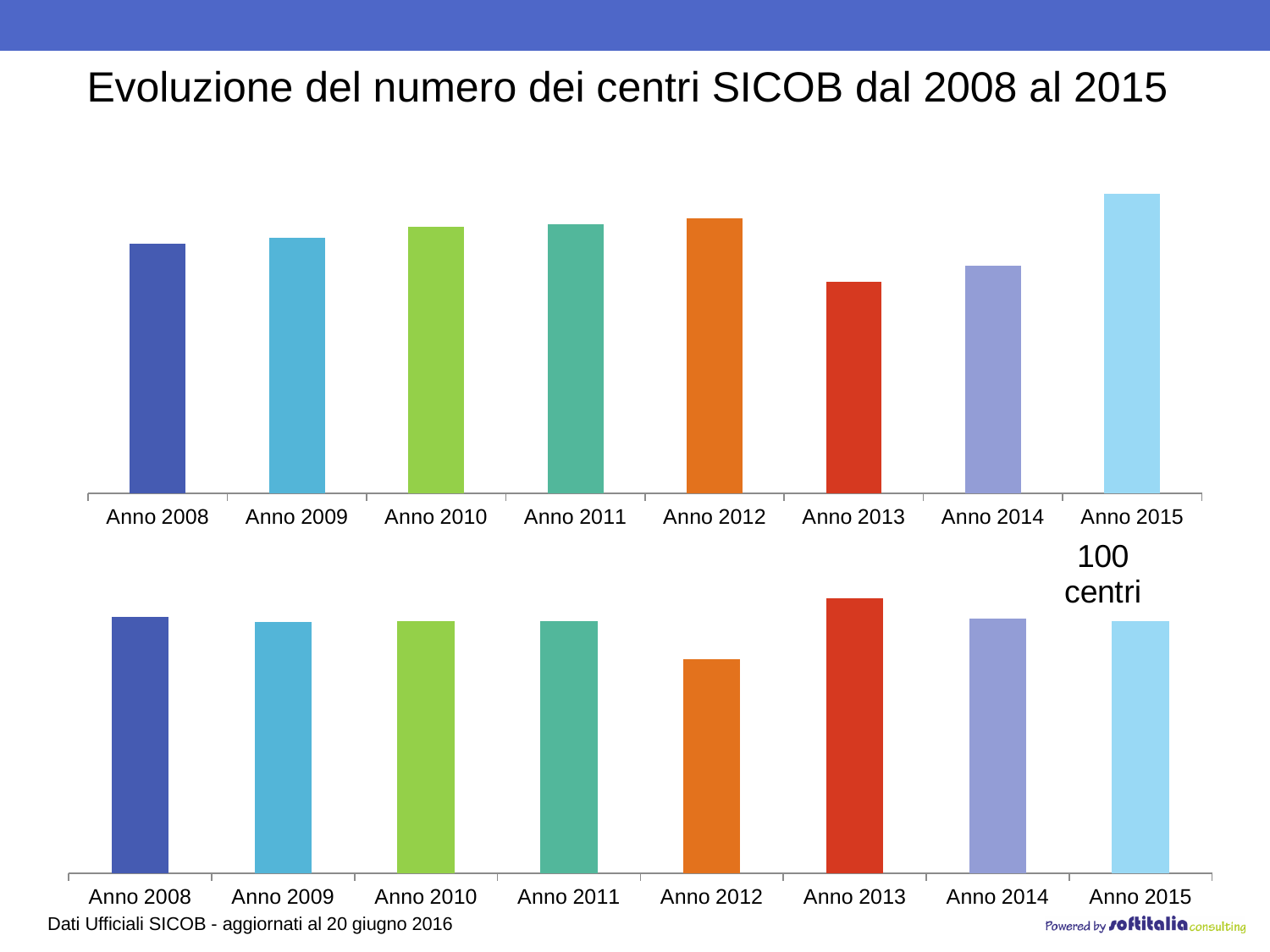
In the top chart, which year has the tallest bar? Anno 2015 In the bottom chart, which year has the shortest bar? Anno 2012 How many categories (years) does the top chart show? 8 In the bottom chart, is the bar for Anno 2008 taller or shorter than the bar for Anno 2012? taller What kind of chart is the top chart on the slide? bar chart What is the title shown above the charts on the slide? Evoluzione del numero dei centri SICOB dal 2008 al 2015 In the top chart, do the bars rise or fall from Anno 2008 to Anno 2012? rise In the top chart, which year has the shortest bar? Anno 2013 What text label appears above the Anno 2015 bar in the bottom chart? 100 centri In the bottom chart, which year has the tallest bar? Anno 2013 In the top chart, is the bar for Anno 2012 taller or shorter than the bar for Anno 2013? taller How many categories (years) does the bottom chart show? 8